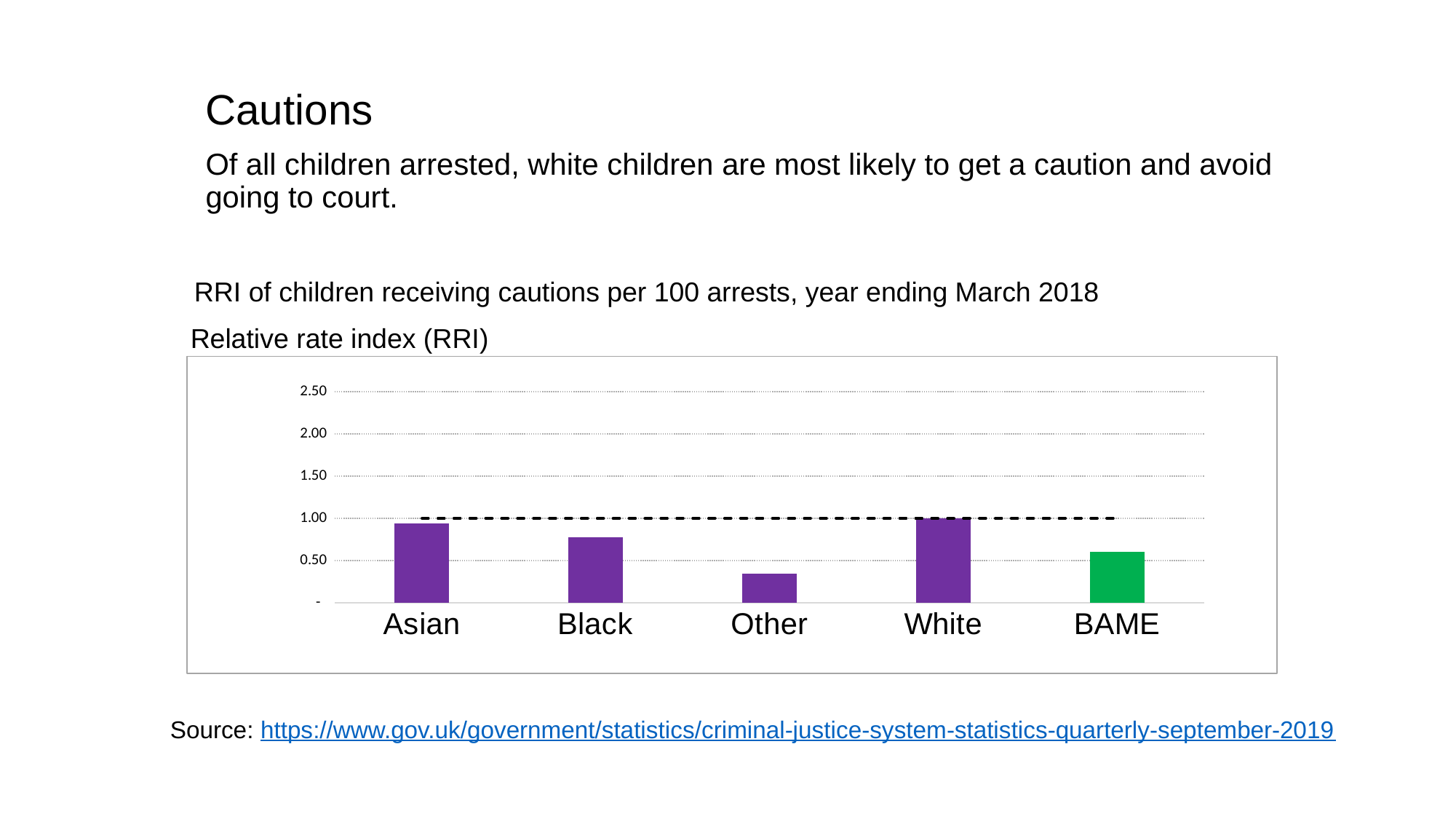
What is the title of the chart? RRI of children receiving cautions per 100 arrests, year ending March 2018 Which has a higher RRI, Black or BAME? Black How many categories are shown on the x axis of the chart? 5 Which category's bar is coloured green rather than purple? BAME Which has a higher RRI, Asian or Black? Asian Is the RRI value for Other greater or less than 0.50? less Which category has the lowest RRI in the chart? Other Which category has the highest RRI in the chart? White Is the RRI value for Black greater or less than 0.50? greater What is the RRI value for White? 1.00 What kind of chart is shown on the slide? bar chart Is the RRI value for Asian greater or less than 1.00? less